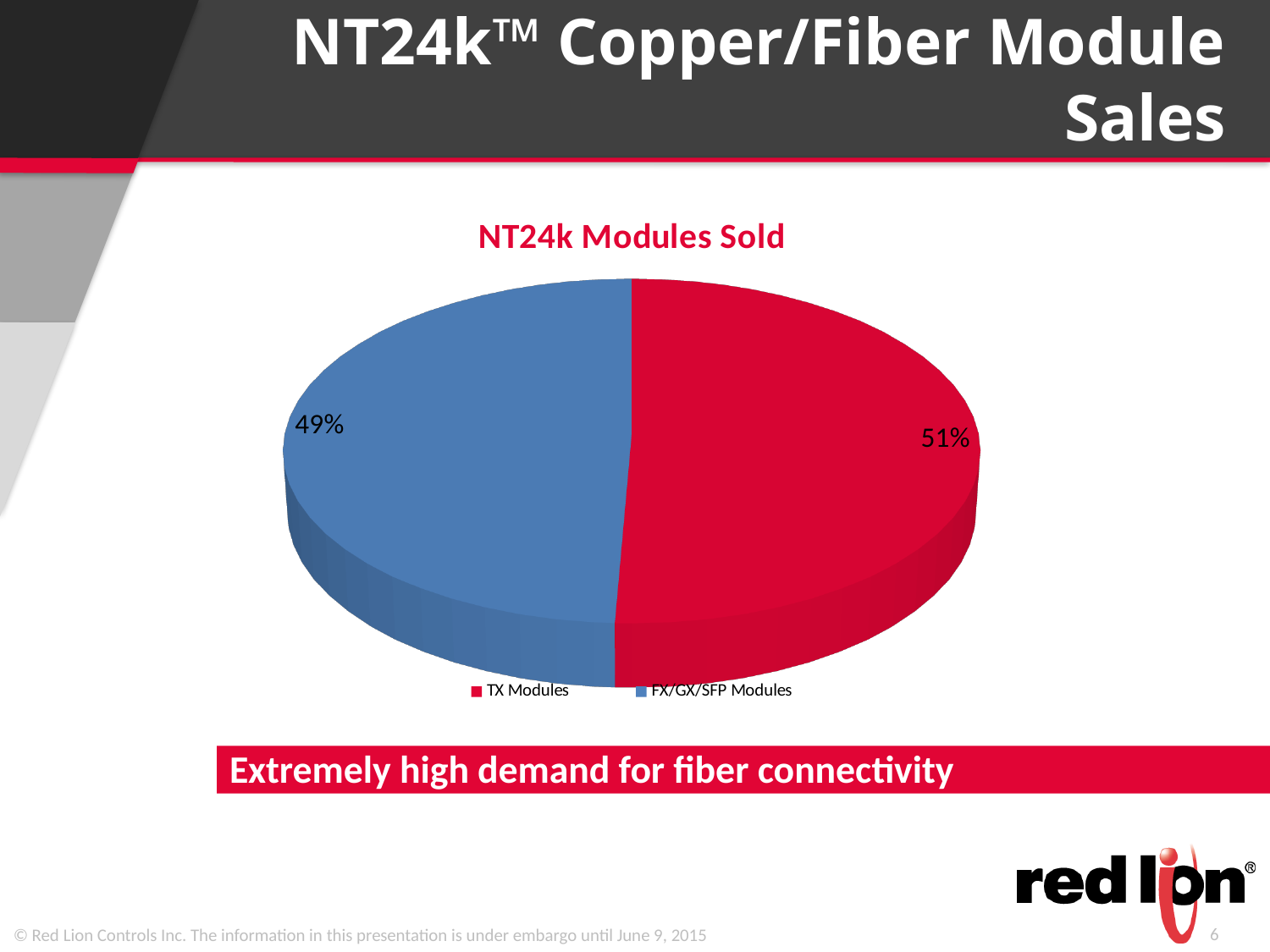
Which category has the largest share of the pie? TX Modules What share of the pie is TX Modules? 51% Which category has the smallest share of the pie? FX/GX/SFP Modules What colour is the TX Modules slice? red Which slice is larger, TX Modules or FX/GX/SFP Modules? TX Modules What kind of chart is shown on the slide? pie chart How many slices does the pie chart have? 2 How many entries does the legend list? 2 What is the title of the chart? NT24k Modules Sold What is the difference in percentage points between the TX Modules share and the FX/GX/SFP Modules share? 2% Is the share for FX/GX/SFP Modules greater or less than 50%? less What share of the pie is FX/GX/SFP Modules? 49%